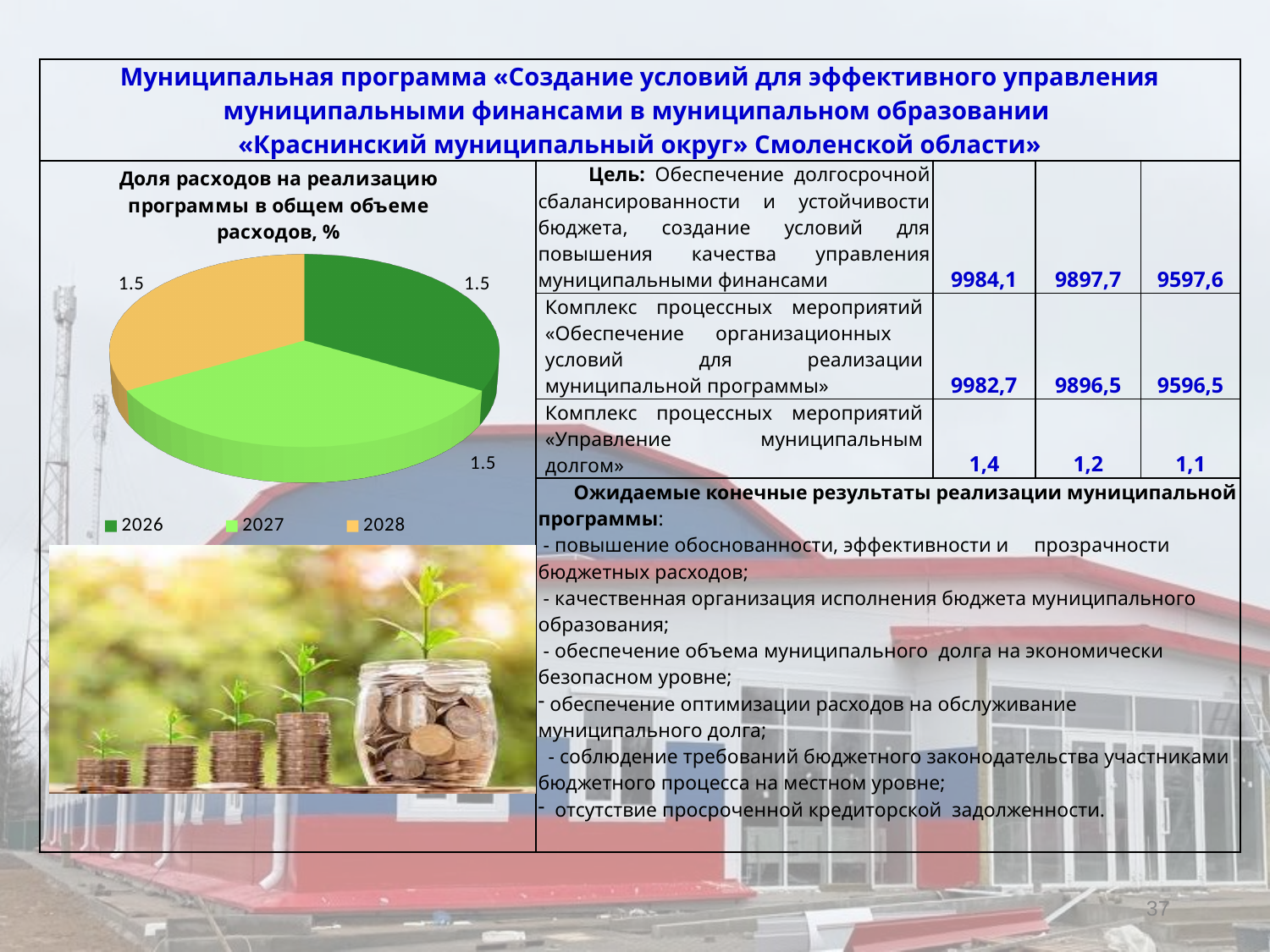
What is the difference between the values for 2026 and 2028 in the pie chart? 0 What is the total of all three values shown in the pie chart? 4.5 What share of the pie does the 2027 slice represent? one third How many slices does the pie chart have? 3 How many entries does the legend of the pie chart list? 3 Which year is shown in orange in the pie chart legend? 2028 What is the value shown for 2026 in the pie chart? 1.5 What type of chart is shown on the slide? pie chart What is the title of the pie chart? Доля расходов на реализацию программы в общем объеме расходов, % What is the value shown for 2028 in the pie chart? 1.5 What is the value shown for 2027 in the pie chart? 1.5